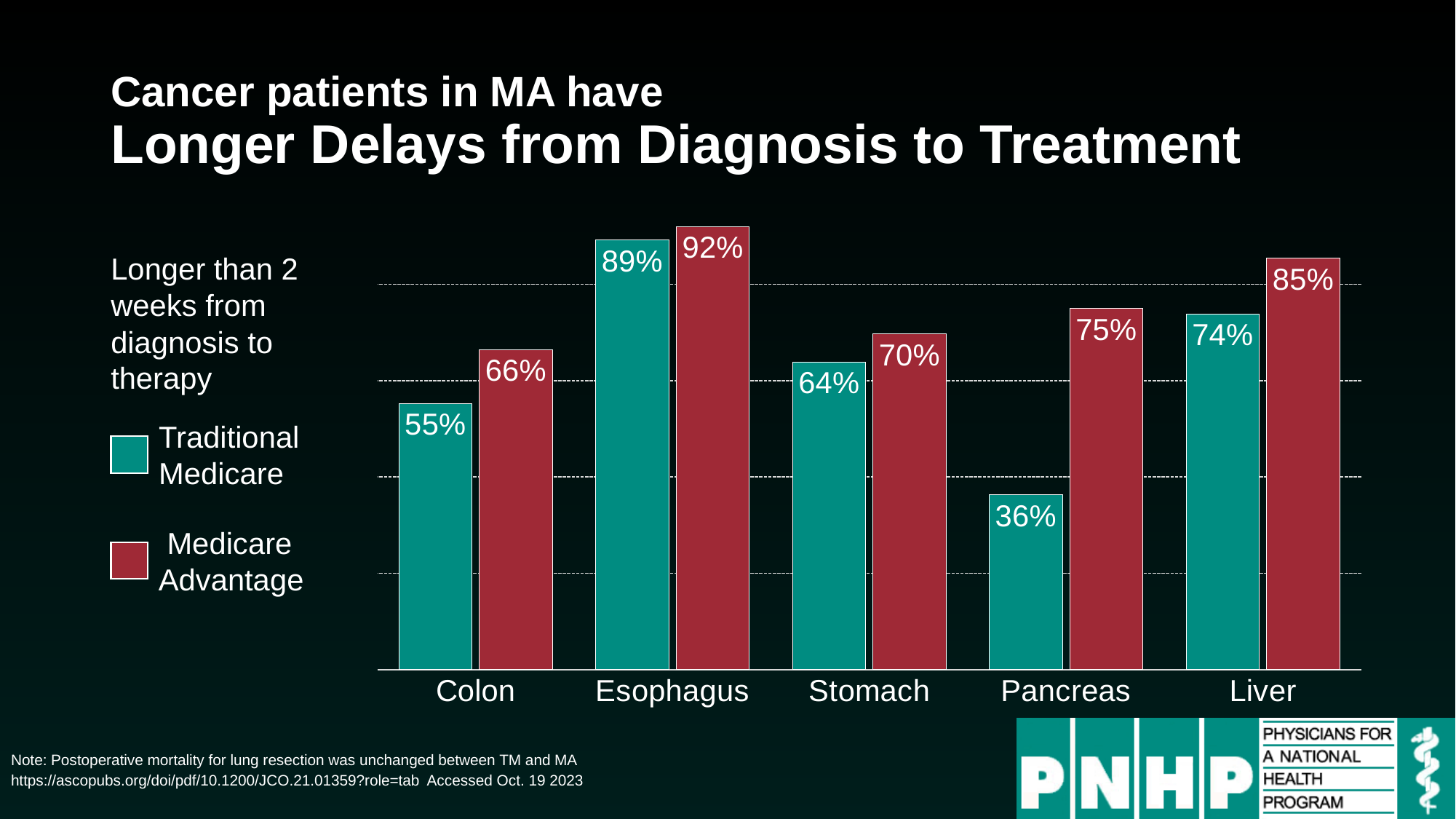
What is the Traditional Medicare value for Colon? 55% What is the Traditional Medicare value for Liver? 74% What is the Medicare Advantage value for Pancreas? 75% Which colour represents Medicare Advantage in the chart? Red How many series does the legend list? 2 Which cancer type has the lowest Traditional Medicare value? Pancreas What kind of chart is shown on the slide? Bar chart What is the difference between the Medicare Advantage and Traditional Medicare values for Colon? 11% Which is larger for Stomach: the Traditional Medicare value or the Medicare Advantage value? Medicare Advantage How many cancer types are shown on the x axis? 5 What is the difference between the Medicare Advantage and Traditional Medicare values for Pancreas? 39% Which cancer type has the highest Medicare Advantage value? Esophagus